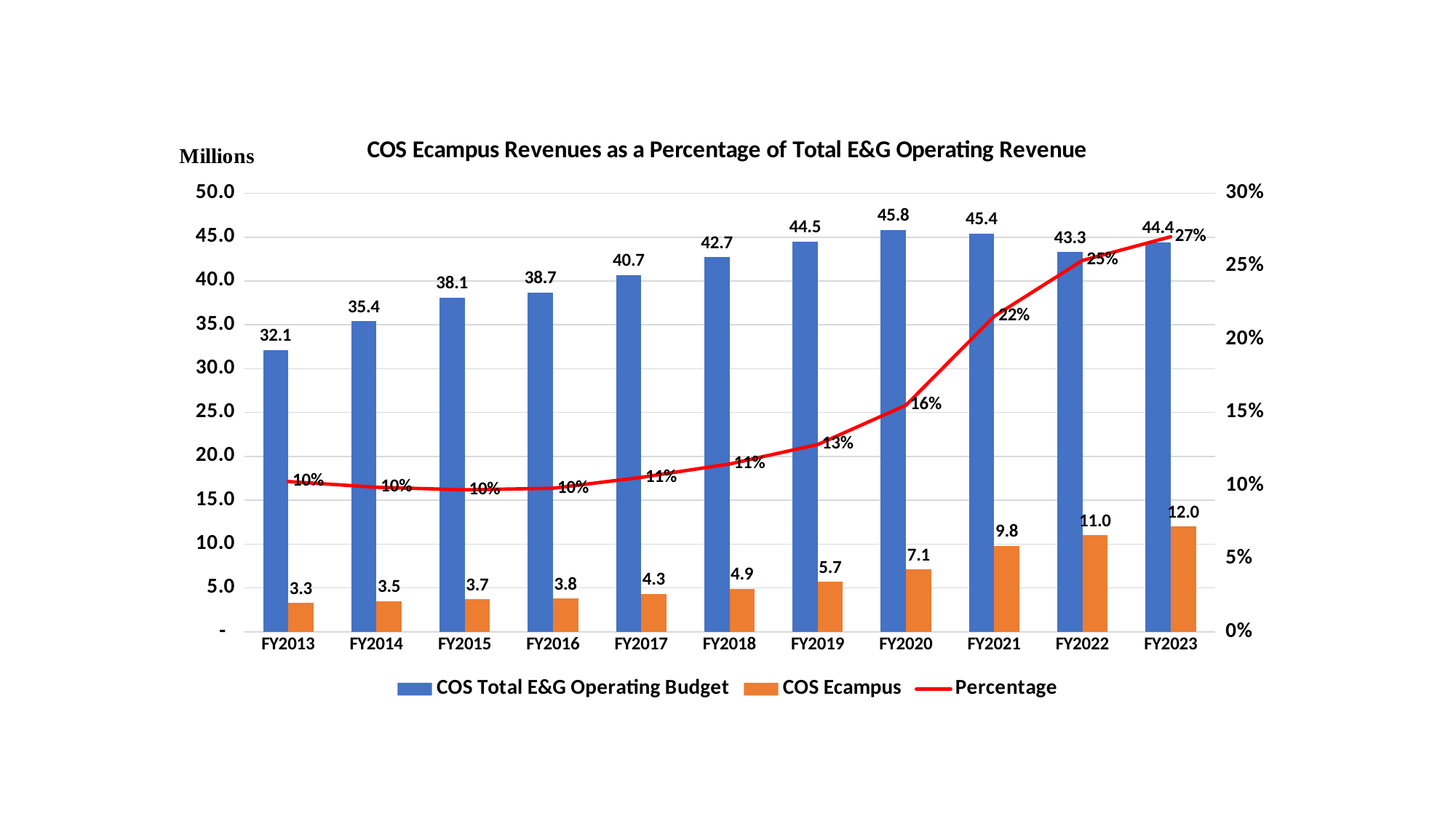
What is the title of the chart? COS Ecampus Revenues as a Percentage of Total E&G Operating Revenue What is the Percentage value for FY2021? 22% Which fiscal year has the highest COS Total E&G Operating Budget? FY2020 How many fiscal years are shown on the x axis? 11 Which is larger, the COS Total E&G Operating Budget for FY2019 or for FY2022? FY2019 How many series does the legend list? 3 What is the COS Total E&G Operating Budget value for FY2020? 45.8 What is the difference between the COS Ecampus values for FY2023 and FY2013? 8.7 Which fiscal year has the lowest COS Ecampus value? FY2013 Does the Percentage line rise or fall from FY2016 to FY2023? Rise What kind of chart is this? Combined bar and line chart What is the COS Ecampus value for FY2023? 12.0